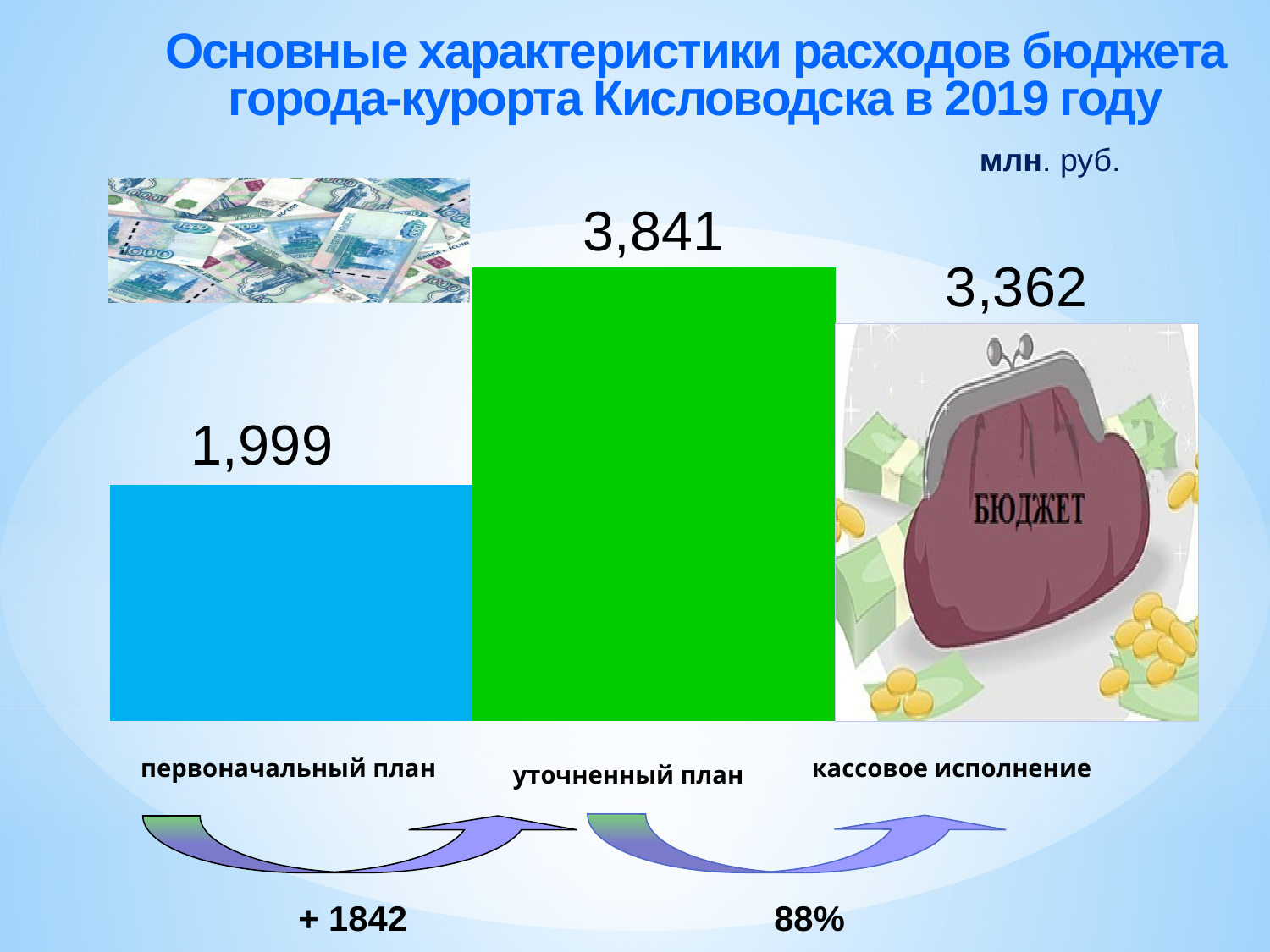
What is the value for «первоначальный план»? 1,999 Which category has the lowest value? первоначальный план What percentage is shown under the arrow between «уточненный план» and «кассовое исполнение»? 88% Which category has the highest value? уточненный план Which is larger, «кассовое исполнение» or «первоначальный план»? кассовое исполнение What is the value for «уточненный план»? 3,841 What is the difference between «уточненный план» and «кассовое исполнение»? 479 How many categories are shown in the chart? 3 What kind of chart is shown on the slide? bar chart What is the value for «кассовое исполнение»? 3,362 What unit of measurement is indicated for the chart values? млн. руб. What is the difference between «уточненный план» and «первоначальный план»? 1,842